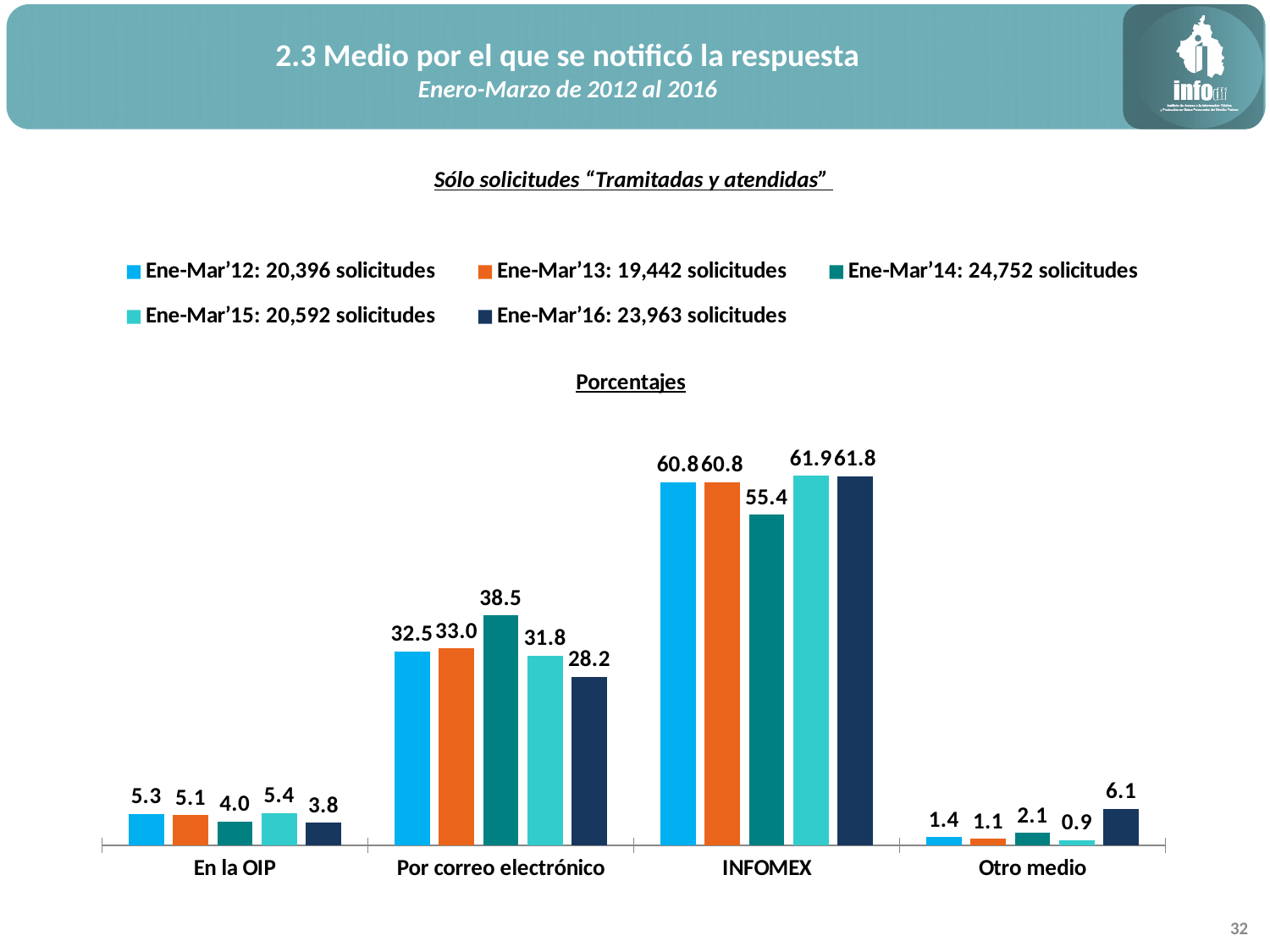
How many solicitudes does the legend give for Ene-Mar'14? 24,752 How many categories are shown on the x axis? 4 What is the value for Por correo electrónico in the Ene-Mar'16 series? 28.2 Which series has the lowest value for En la OIP? Ene-Mar'16 What is the value for INFOMEX in the Ene-Mar'14 series? 55.4 Which series has the highest value for Por correo electrónico? Ene-Mar'14 What is the difference between the Ene-Mar'14 and Ene-Mar'16 values for Por correo electrónico? 10.3 What is the value for Otro medio in the Ene-Mar'15 series? 0.9 What kind of chart is shown on the slide? bar chart Which category has the highest value in the Ene-Mar'12 series? INFOMEX How many series does the legend list? 5 Which is larger for Otro medio: the Ene-Mar'16 value or the Ene-Mar'14 value? Ene-Mar'16